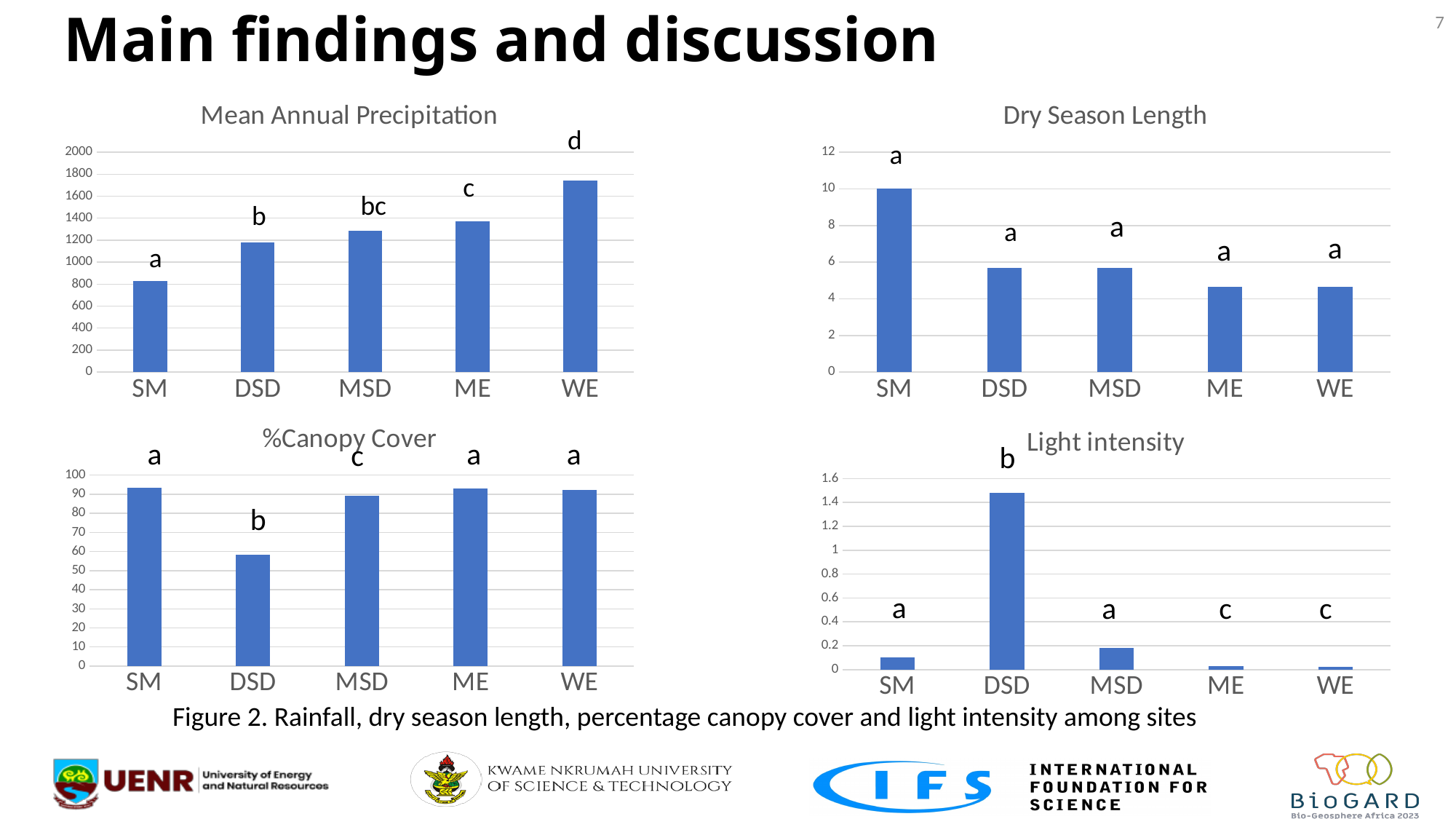
In the Dry Season Length chart, which site has the highest value? SM In the Mean Annual Precipitation chart, is the value for WE greater or less than 1600? greater In the Light intensity chart, which site has the highest value? DSD In the Mean Annual Precipitation chart, is the value for SM greater or less than 1000? less In the Mean Annual Precipitation chart, which site has the highest value? WE In the Mean Annual Precipitation chart, which site has the lowest value? SM In the %Canopy Cover chart, which site has the lowest value? DSD What kind of chart is the Dry Season Length chart? bar chart How many sites are shown on the x axis of the Light intensity chart? 5 In the %Canopy Cover chart, is the value for DSD greater or less than 70? less